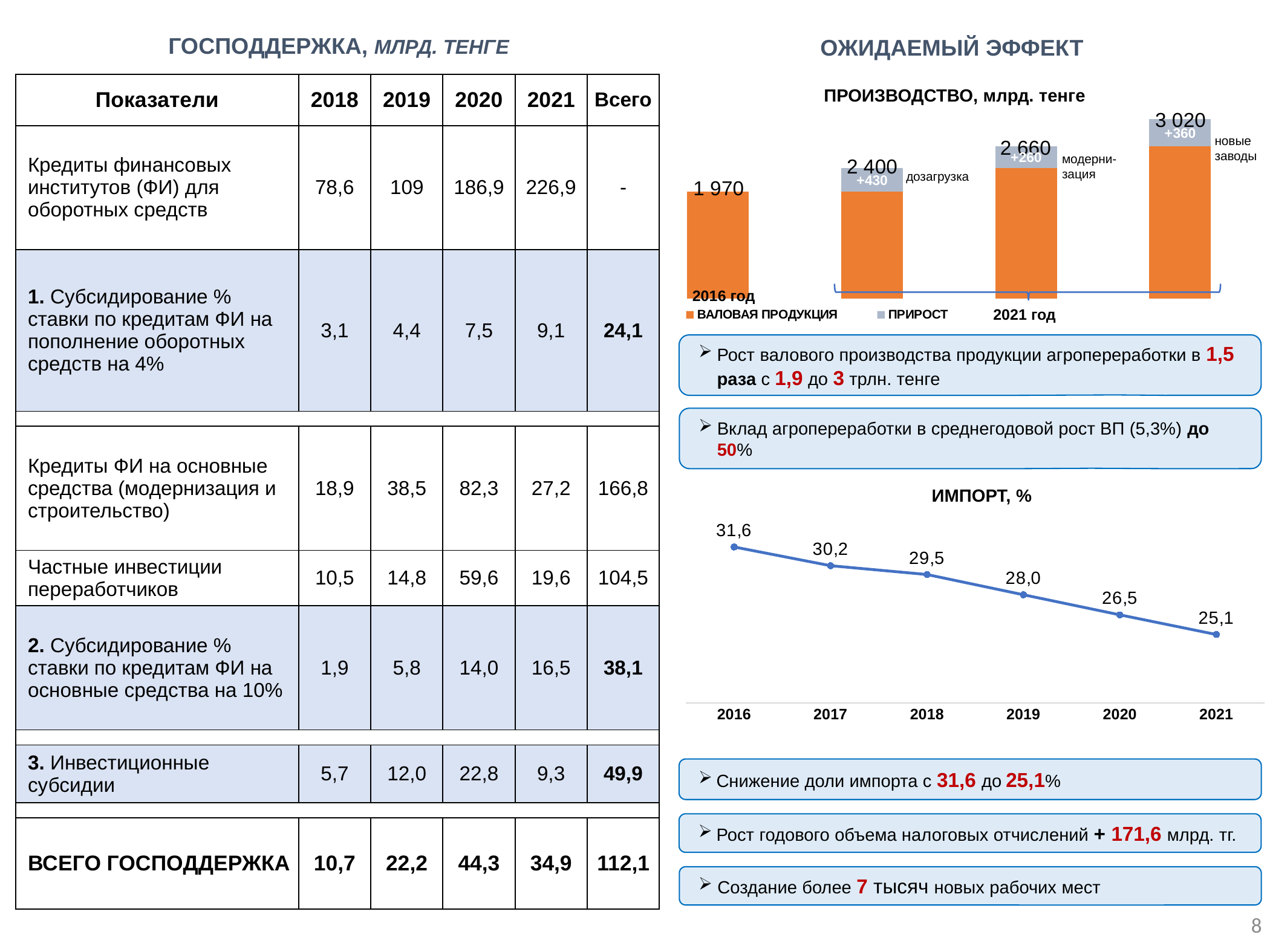
In the 'ИМПОРТ, %' chart, what is the value for 2019? 28,0 In the 'ИМПОРТ, %' chart, what is the value for 2016? 31,6 In the 'ИМПОРТ, %' chart, do the values rise or fall from 2016 to 2021? fall In the 'ИМПОРТ, %' chart, which year has the highest value? 2016 In the 'ПРОИЗВОДСТВО, млрд. тенге' chart, what is the value of the bar for 2016 год? 1 970 In the 'ИМПОРТ, %' chart, what is the difference between the 2016 and 2021 values? 6,5 What kind of chart is the 'ПРОИЗВОДСТВО, млрд. тенге' chart? bar chart How many data points are plotted in the 'ИМПОРТ, %' chart? 6 In the 'ПРОИЗВОДСТВО, млрд. тенге' chart, what is the total of the tallest bar (labelled 'новые заводы')? 3 020 What kind of chart is the 'ИМПОРТ, %' chart? line chart How many series does the legend of the 'ПРОИЗВОДСТВО, млрд. тенге' chart list? 2 In the 'ИМПОРТ, %' chart, which year has the lowest value? 2021